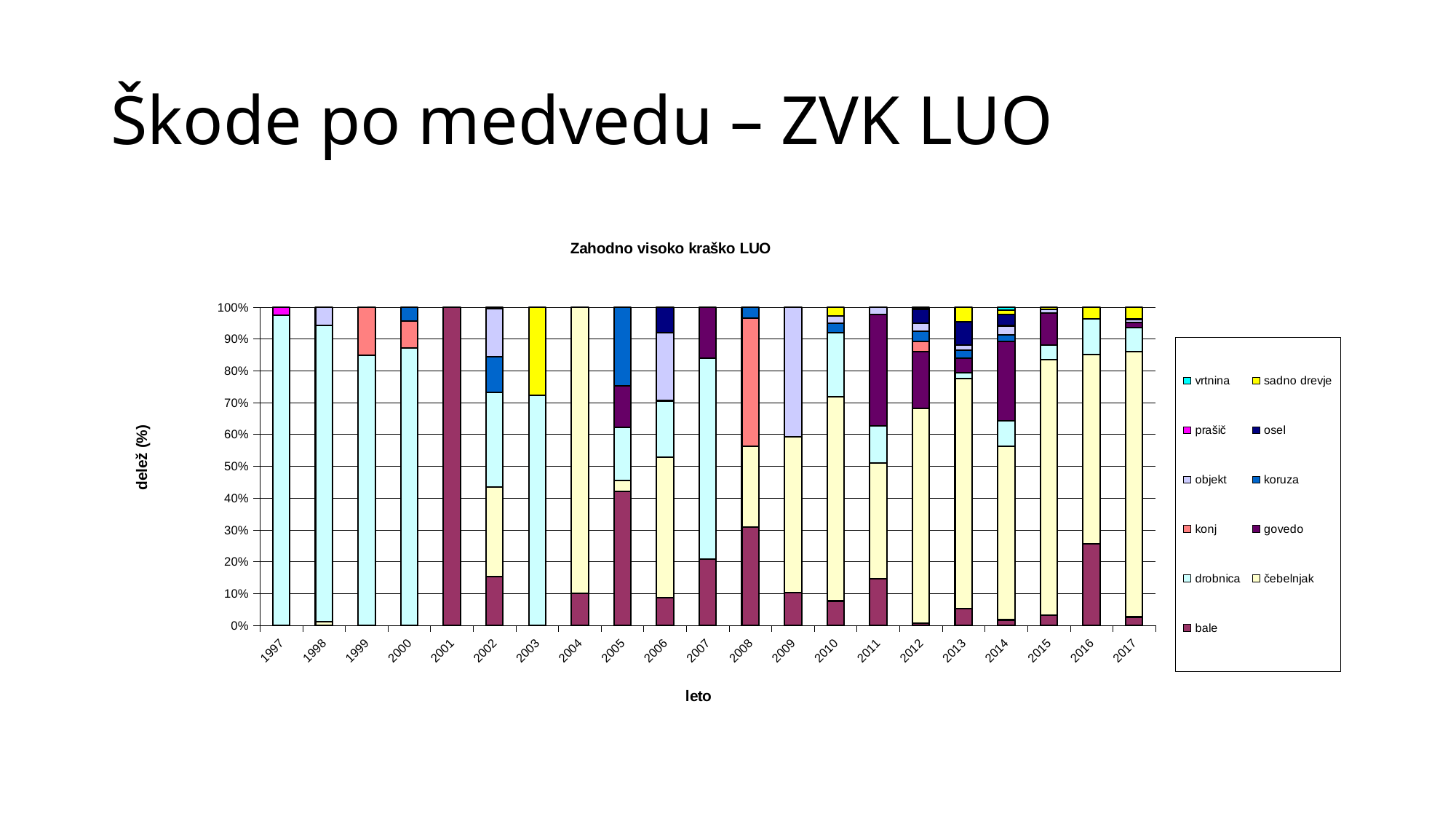
In which year does bale make up the largest share of the bar? 2001 What is the label of the y axis? delež (%) Is the share of bale in 2005 greater or less than 30%? greater What kind of chart is shown on the slide? stacked bar chart Which is larger, the share of bale in 2001 or the share of bale in 2010? 2001 What is the share of bale in 2001? 100% Is the share of drobnica in 2003 greater or less than 60%? greater How many years are shown on the x axis of the chart? 21 What is the title of the chart? Zahodno visoko kraško LUO Is the share of bale in 2016 greater or less than 20%? greater How many series does the chart legend list? 11